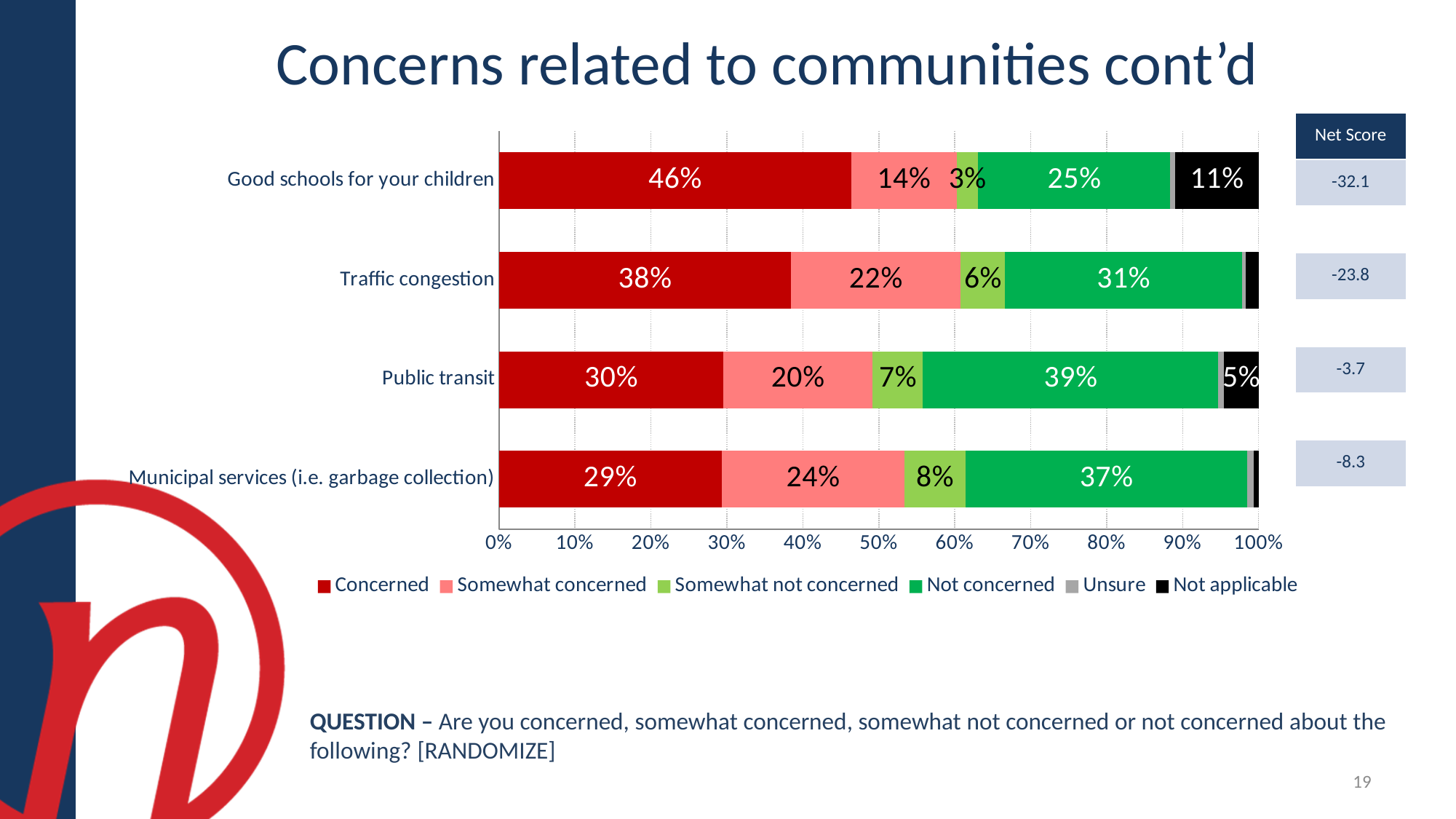
What is the Not concerned value for Public transit? 39% What is the Somewhat concerned value for Municipal services (i.e. garbage collection)? 24% What is the Not applicable value for Good schools for your children? 11% What is the difference in the Concerned percentage between Good schools for your children and Traffic congestion? 8 percentage points How many series does the legend list? 6 Which has a larger Somewhat concerned value, Traffic congestion or Public transit? Traffic congestion Which category has the lowest Concerned percentage? Municipal services (i.e. garbage collection) What percentage of respondents are Concerned about Good schools for your children? 46% Which category has the highest Concerned percentage? Good schools for your children What type of chart is shown on the slide? Stacked bar chart Which category has the highest Not concerned percentage? Public transit How many categories are shown on the chart? 4